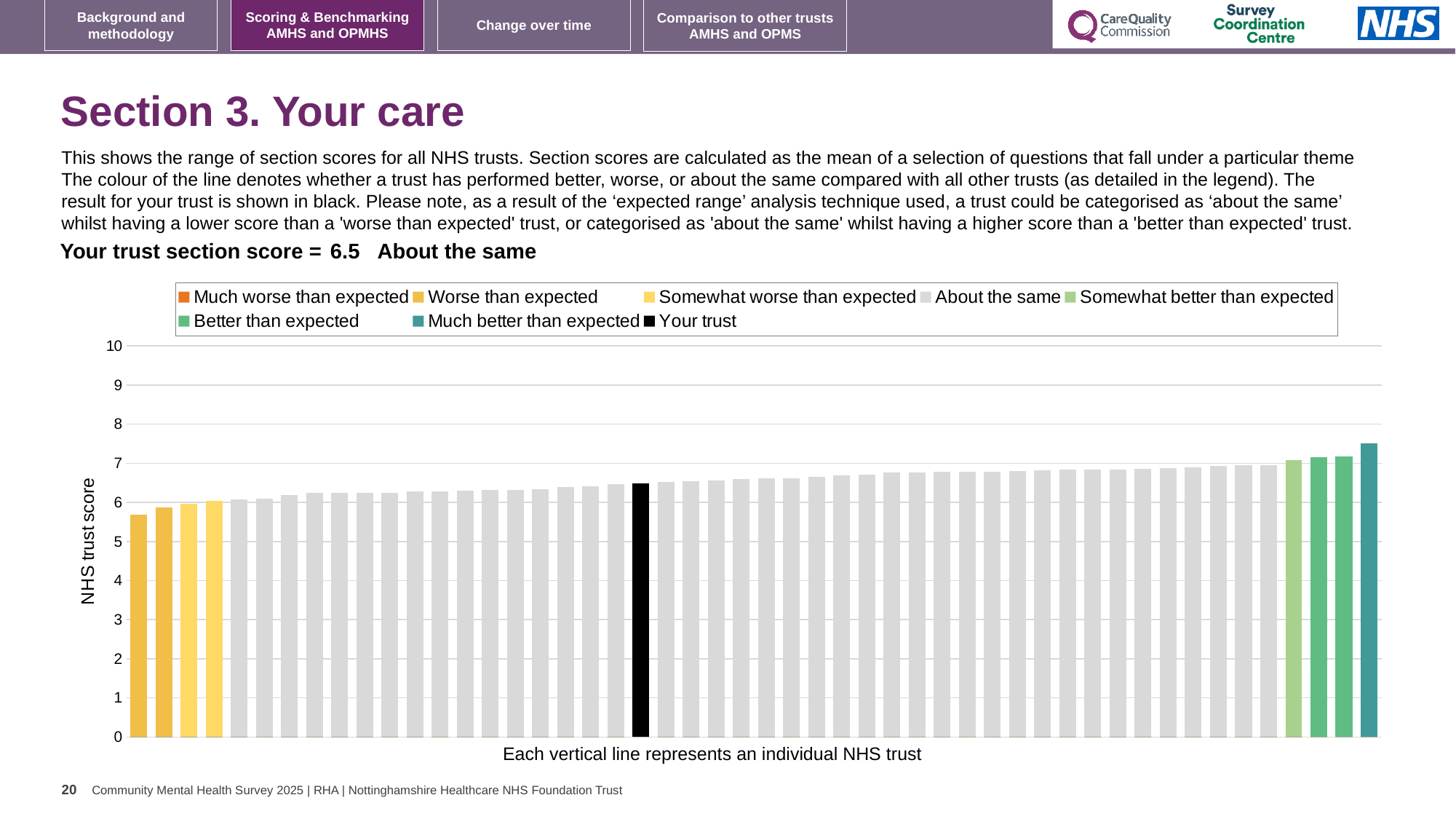
Is the value of the lowest bar greater or less than 5? greater Which category is your trust placed in for this section? About the same Is the value of the lowest bar greater or less than 6? less What kind of chart is shown on the slide? bar chart What is the label on the vertical axis? NHS trust score Do the bar values rise or fall from left to right along the x axis? rise Which legend category does the highest bar belong to? Much better than expected Is the value of the highest bar greater or less than 8? less What is the section score for your trust? 6.5 How many entries does the legend list? 8